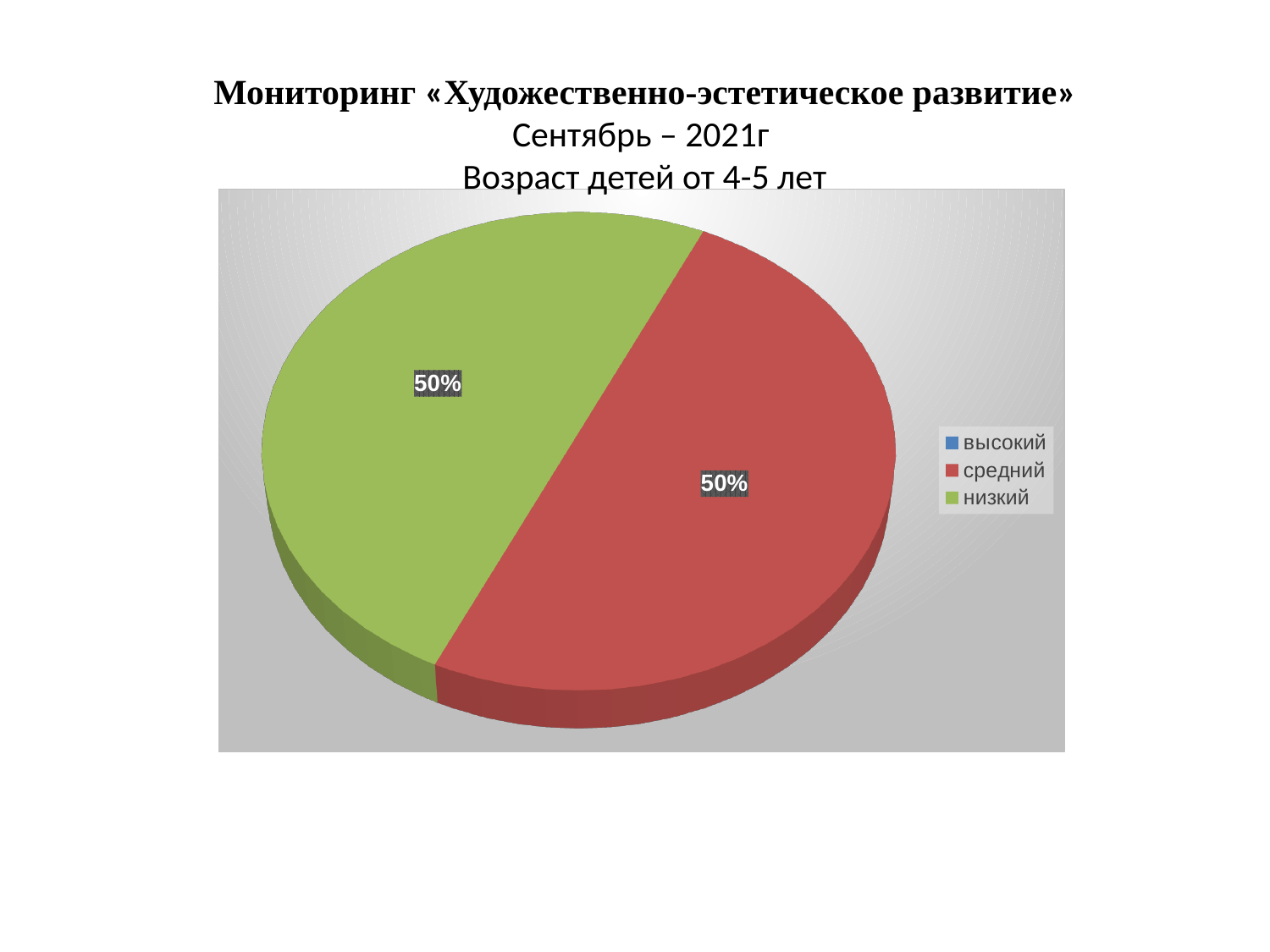
Which colour represents "низкий" in the legend? green Which colour represents "средний" in the legend? red How many slices with printed values are visible in the pie? 2 How many entries does the legend list? 3 What kind of chart is shown on the slide? pie chart What is the difference between the "средний" and "низкий" shares? 0% What value is printed on the red slice of the pie? 50% What share of the pie does the "средний" slice represent? 50% What value is printed on the green slice of the pie? 50% What share of the pie does the "низкий" slice represent? 50%